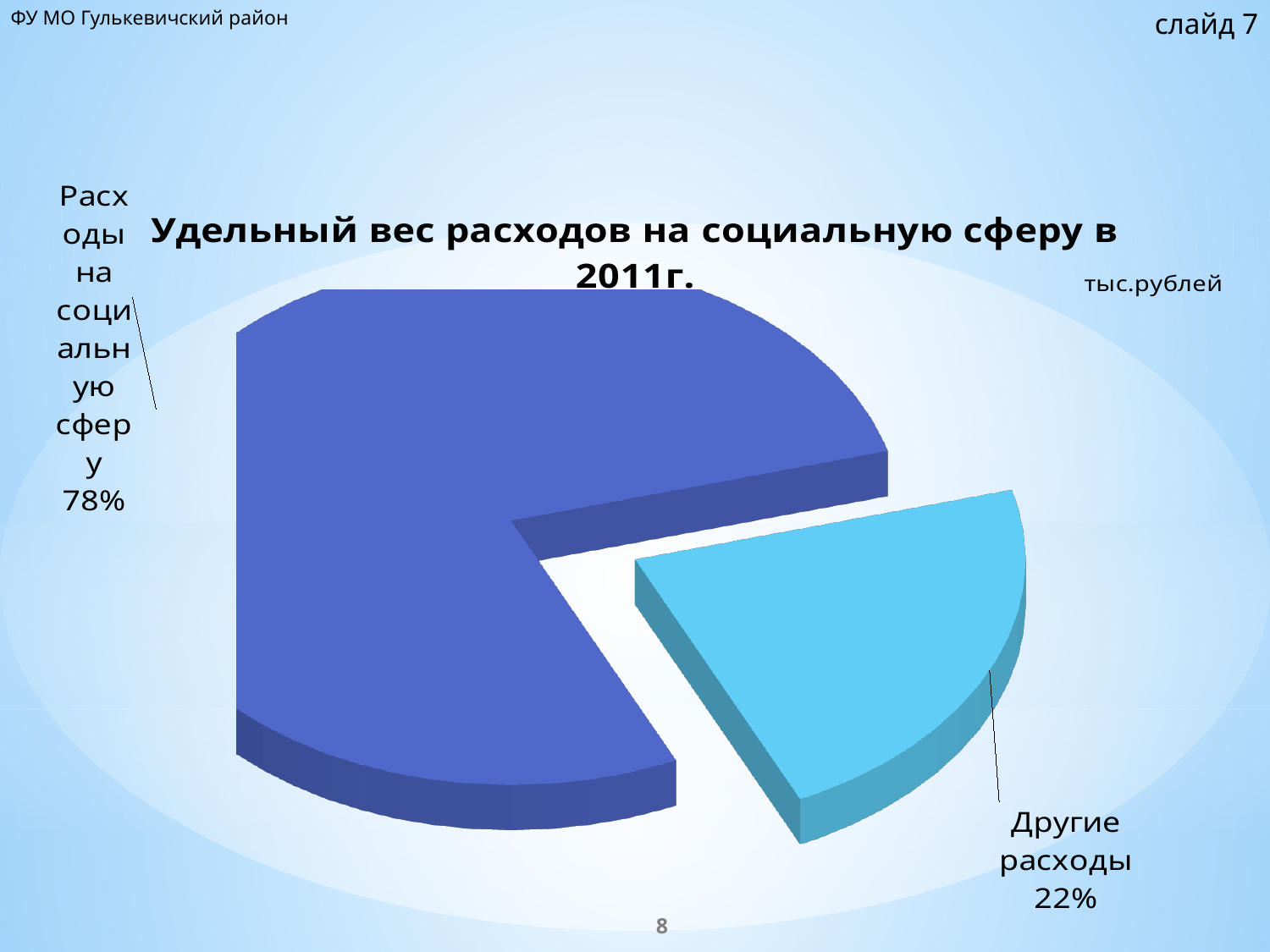
Which slice of the pie is the largest? Расходы на социальную сферу What colour is the "Другие расходы" slice? Light blue Is the share for "Другие расходы" greater or less than 50%? less What share of the pie is labelled "Расходы на социальную сферу"? 78% Which slice of the pie is the smallest? Другие расходы Which is larger: the share for "Расходы на социальную сферу" or the share for "Другие расходы"? Расходы на социальную сферу What kind of chart is shown on the slide? Pie chart How many slices does the pie chart have? 2 What share of the pie is labelled "Другие расходы"? 22% What is the title of the chart? Удельный вес расходов на социальную сферу в 2011г. What is the difference in percentage points between the "Расходы на социальную сферу" slice and the "Другие расходы" slice? 56